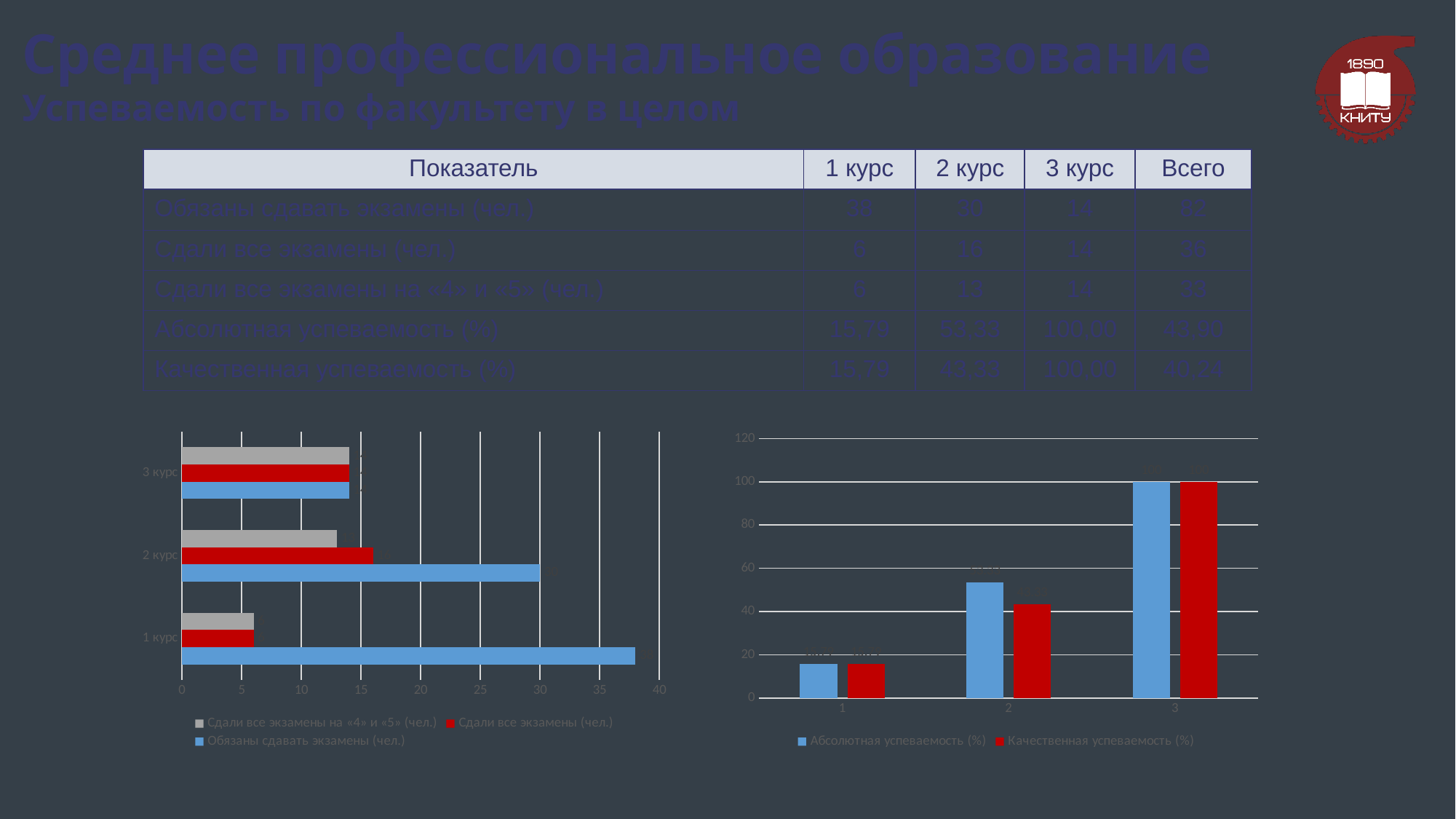
What kind of chart is the chart on the left of the slide? bar chart What kind of chart is the chart on the right of the slide? bar chart How many categories are shown on the left chart? 3 How many series does the legend of the left chart list? 3 On the right chart, do the values of Абсолютная успеваемость (%) rise or fall from category 1 to category 3? rise On the left chart, which category has the highest value for Обязаны сдавать экзамены (чел.)? 1 курс On the left chart, what is the value of Обязаны сдавать экзамены (чел.) for 2 курс? 30 On the left chart, is the value of Сдали все экзамены (чел.) for 2 курс greater or less than 15? greater On the left chart, is the value of Обязаны сдавать экзамены (чел.) for 1 курс greater or less than 35? greater How many series does the legend of the right chart list? 2 On the left chart, which category has the lowest value for Сдали все экзамены (чел.)? 1 курс On the right chart, what is the value of Абсолютная успеваемость (%) for category 3? 100